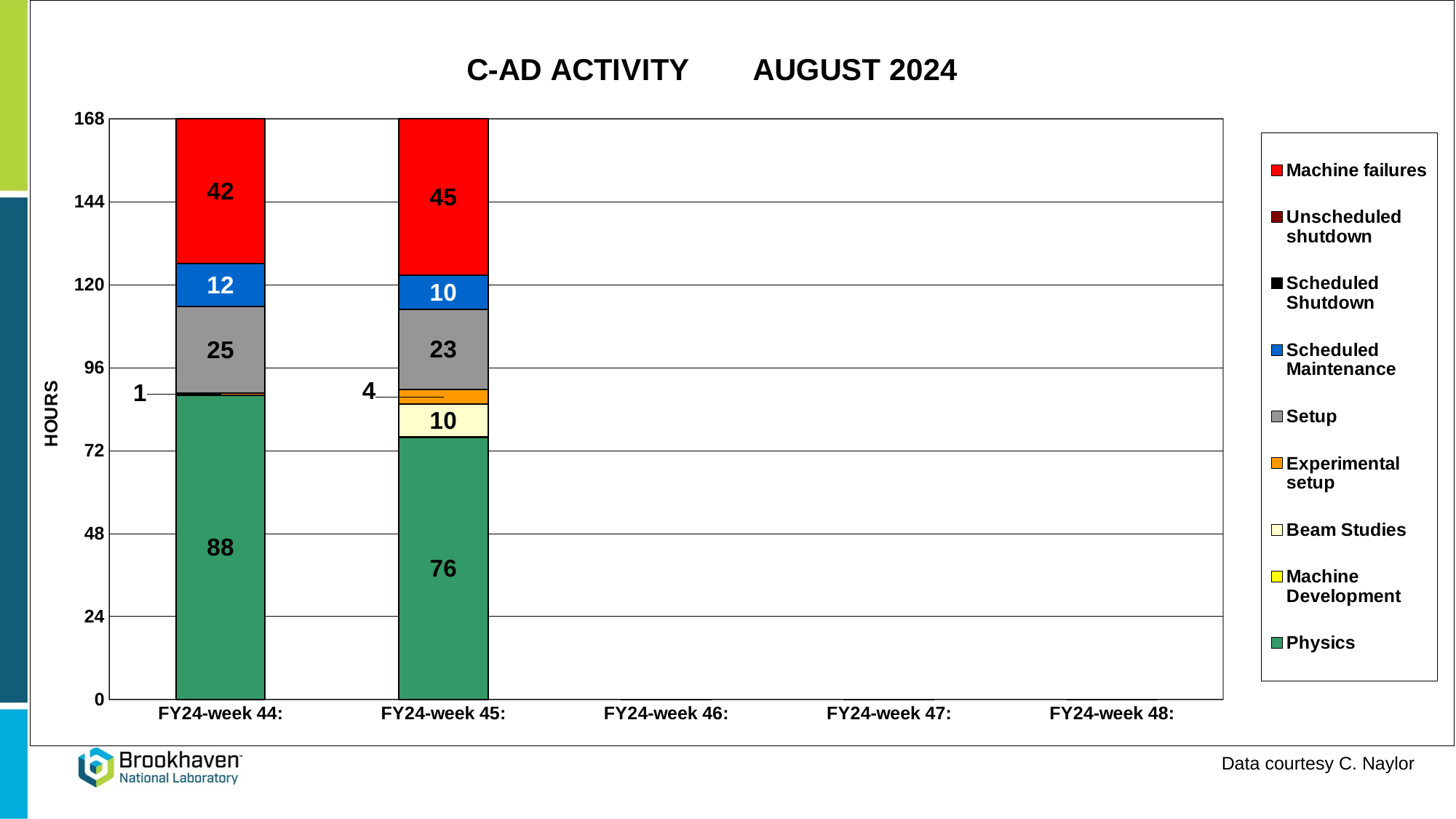
How many series does the legend list? 9 What is the total of the stacked bar for FY24-week 44? 168 What is the Setup value for FY24-week 45? 23 How many week categories are labelled on the x axis? 5 What kind of chart is shown on the slide? Stacked bar chart What is the Machine failures value for FY24-week 45? 45 What is the Beam Studies value for FY24-week 45? 10 What is the title of the chart? C-AD ACTIVITY AUGUST 2024 What is the Scheduled Maintenance value for FY24-week 44? 12 Which week has more Machine failures hours, FY24-week 44 or FY24-week 45? FY24-week 45 What is the difference in Physics hours between FY24-week 44 and FY24-week 45? 12 What is the Physics value for FY24-week 44? 88